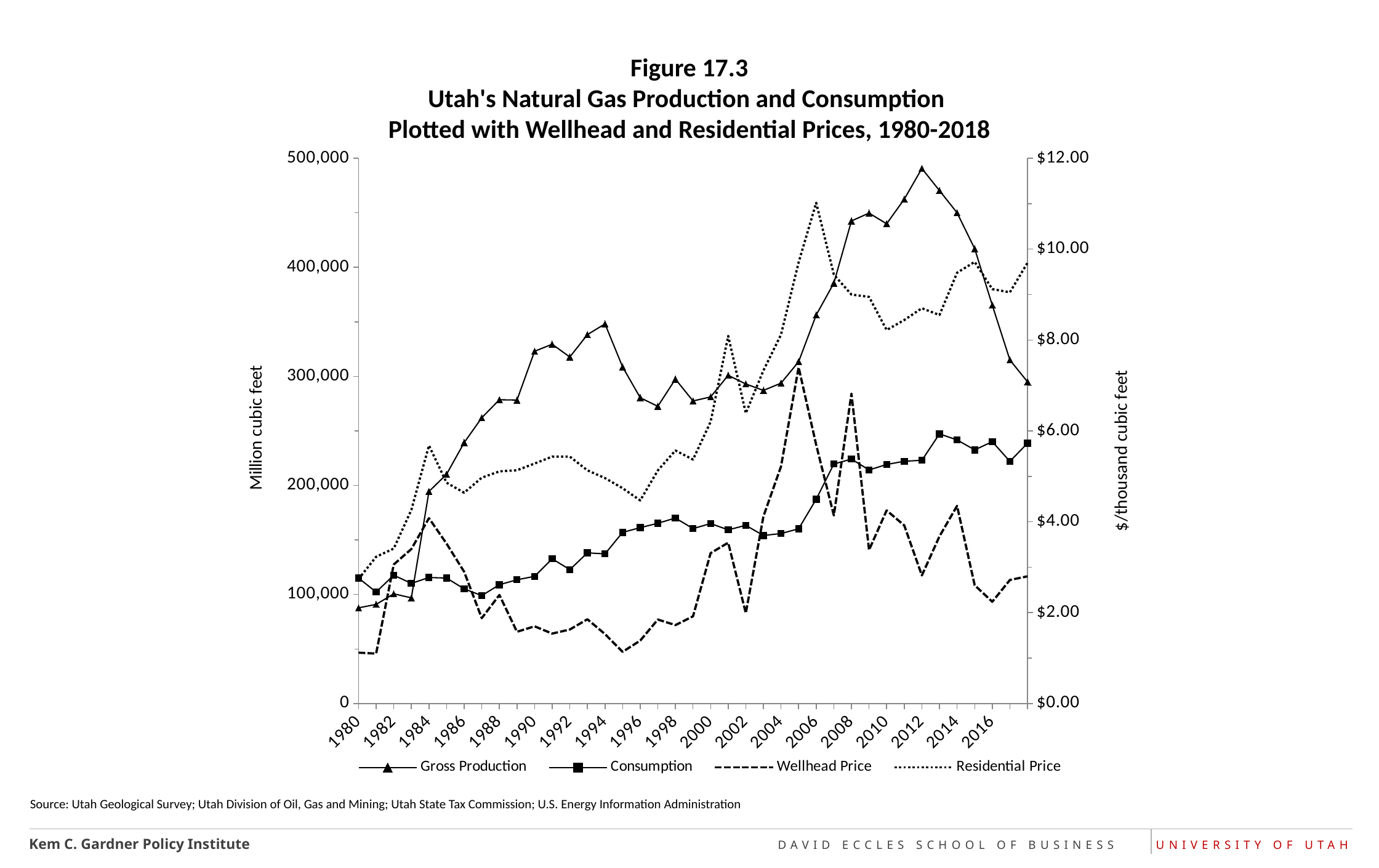
Does Consumption generally rise or fall from 1980 to 2018? rise Does Gross Production rise or fall between 2013 and 2018? fall What kind of chart is shown on the slide? Line chart In which year does Gross Production reach its highest value? 2012 Is the Consumption value for 1980 greater or less than 200,000? less What is the title of the right-hand vertical axis? $/thousand cubic feet Is the Wellhead Price for 1980 greater or less than $2.00? less How many series does the legend list? 4 Is the Gross Production value for 2013 greater or less than 400,000? greater In 2018, which is larger: Gross Production or Consumption? Gross Production What are the four series named in the legend? Gross Production, Consumption, Wellhead Price, Residential Price